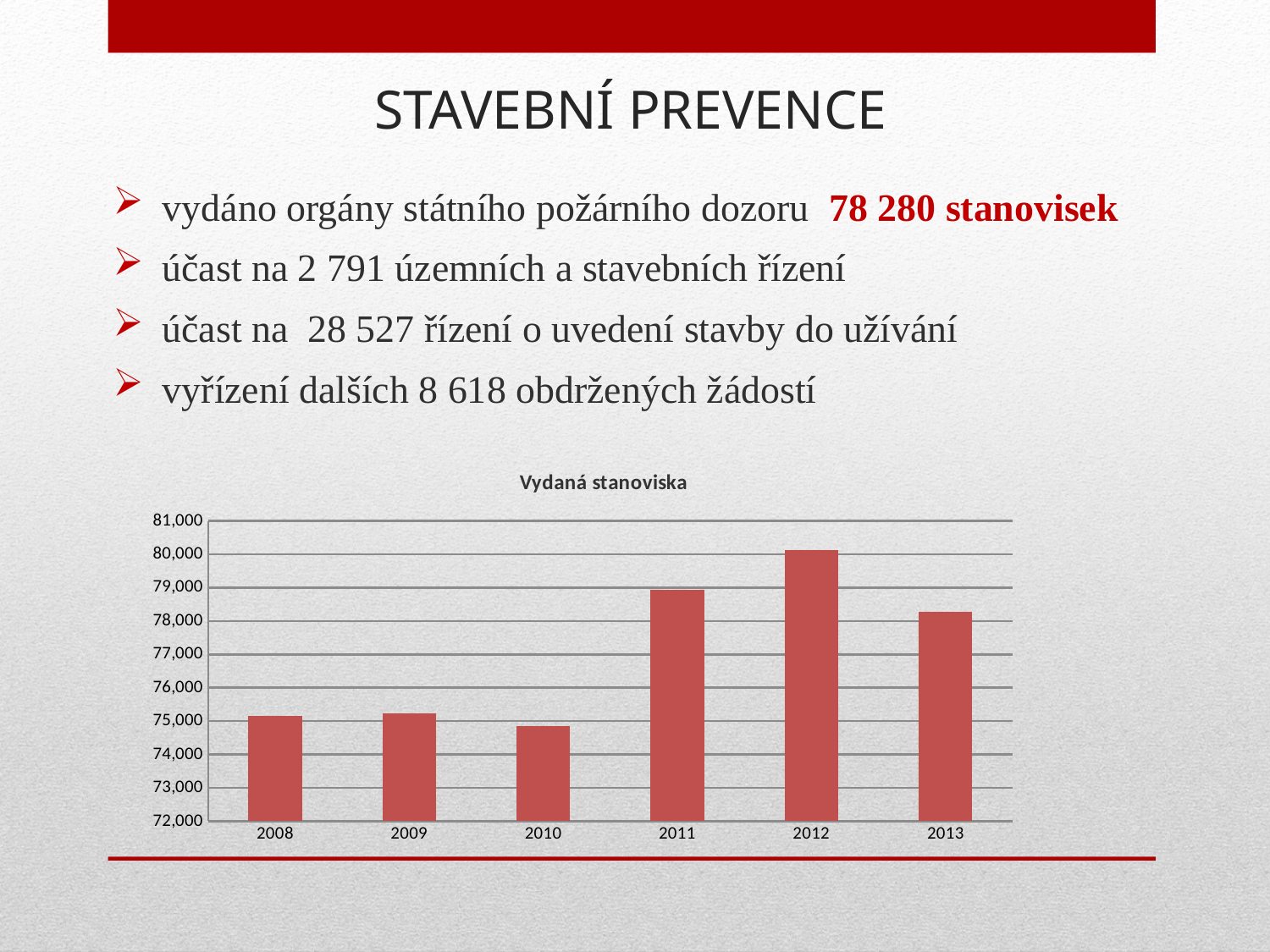
Is the value for 2010 greater or less than 75,000? less What colour are the bars in the chart? red Is the value for 2013 greater or less than 78,000? greater What is the title of the chart? Vydaná stanoviska What kind of chart is shown on the slide? bar chart Which year has the larger value, 2011 or 2013? 2011 Which year has the highest bar in the chart? 2012 How many years are shown on the x axis of the chart? 6 Which year has the larger value, 2010 or 2012? 2012 Is the value for 2012 greater or less than 79,000? greater Which year has the lowest bar in the chart? 2010 Do the values rise or fall from 2010 to 2012? rise